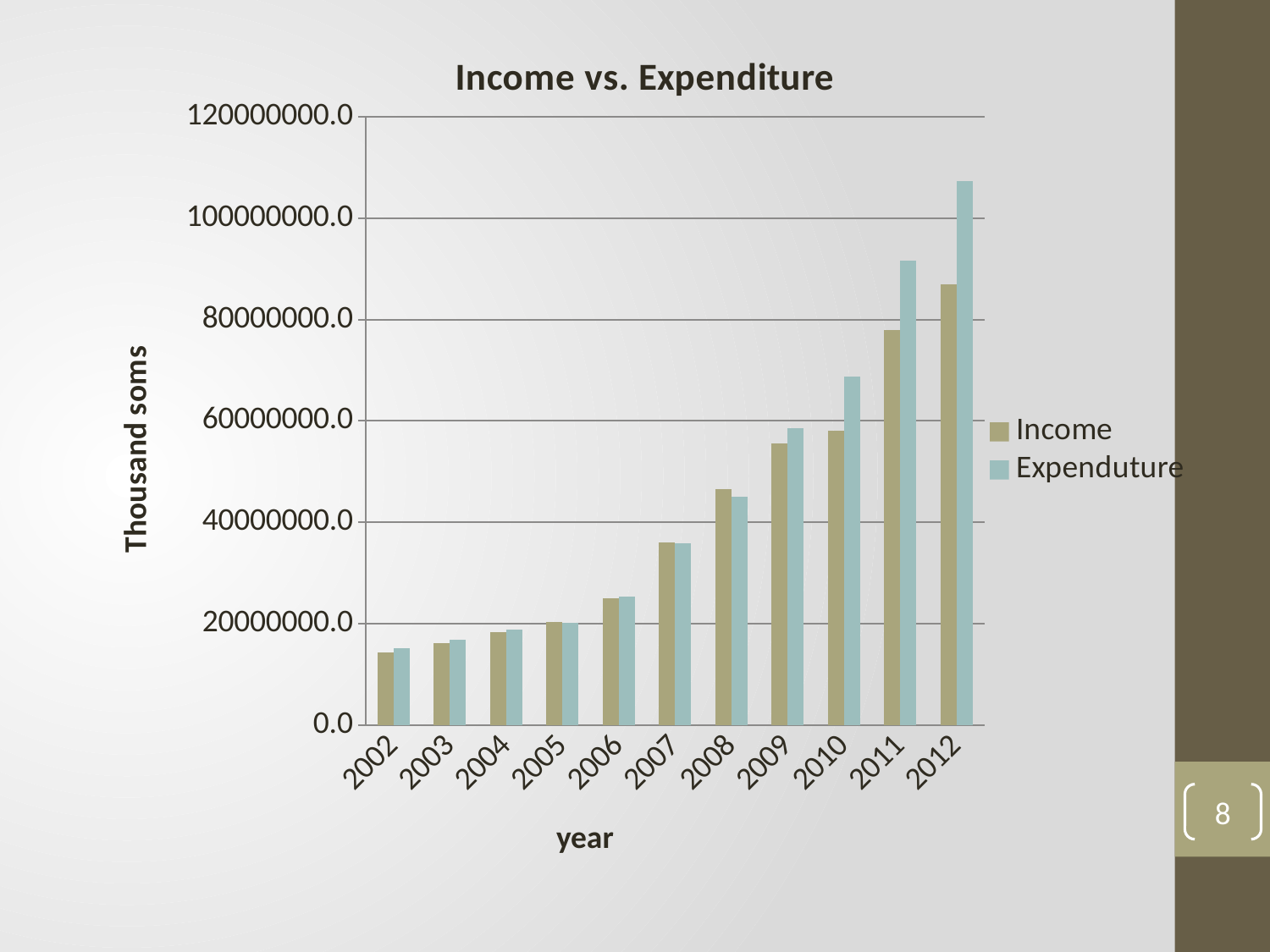
Is the Expenduture value for 2010 greater or less than 60000000.0? greater In 2011, which is larger, Income or Expenduture? Expenduture Which year has the lowest Income value? 2002 How many series does the legend list? 2 Is the Income value for 2002 greater or less than 20000000.0? less Do the Income values generally rise or fall from 2002 to 2012? rise What kind of chart is shown on the slide? bar chart How many years are shown on the x axis? 11 Is the Income value for 2011 greater or less than 80000000.0? less What is the title of the chart? Income vs. Expenditure Which year has the highest Expenduture value? 2012